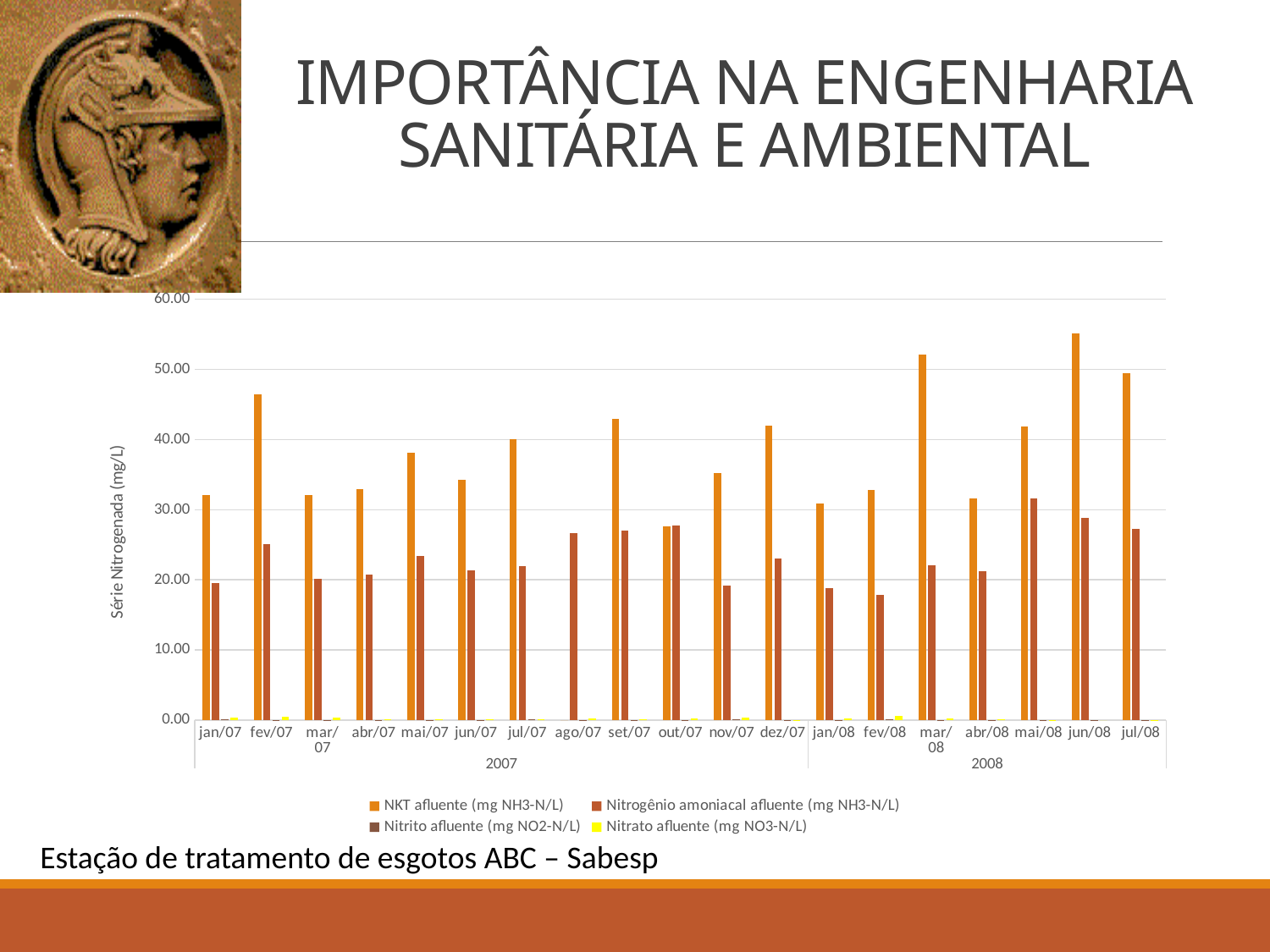
Is the NKT afluente value for mar/08 greater or less than 50.00? greater Is the Nitrogênio amoniacal afluente value for fev/08 greater or less than 20.00? less What is the title of the vertical axis? Série Nitrogenada (mg/L) Which month has the larger NKT afluente value, fev/07 or mar/07? fev/07 How many months are shown along the x axis? 19 What kind of chart is shown on the slide? bar chart Is the Nitrogênio amoniacal afluente value for fev/07 greater or less than 20.00? greater In which month is the NKT afluente value highest? jun/08 In which month is the Nitrogênio amoniacal afluente value highest? mai/08 How many series does the legend list? 4 Which month has the larger Nitrogênio amoniacal afluente value, jan/08 or mai/08? mai/08